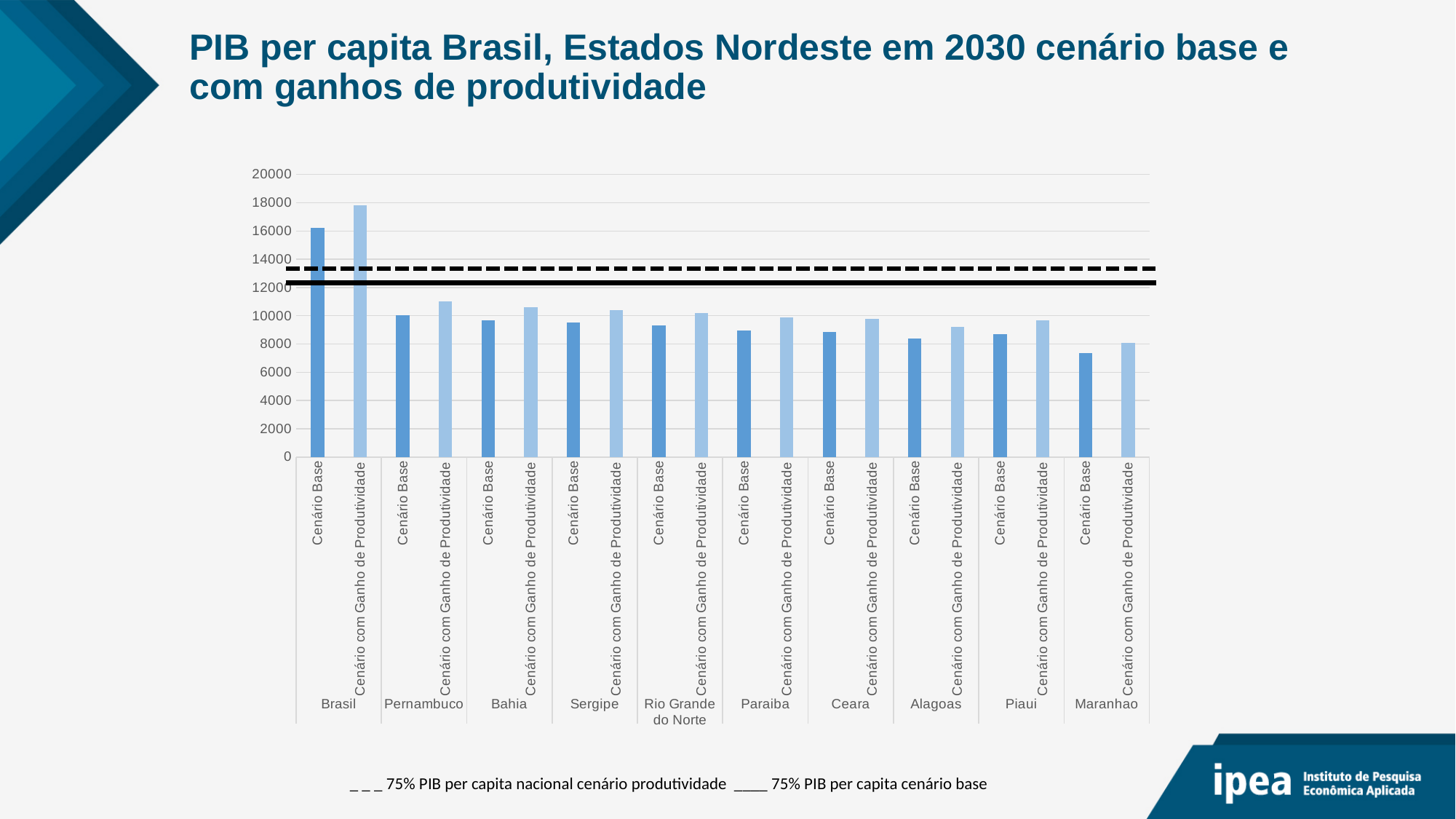
Is the Cenário com Ganho de Produtividade value for Brasil greater or less than 16000? greater Which region has the lowest Cenário Base bar? Maranhao Is the Cenário Base value for Alagoas greater or less than 10000? less For Piaui, which bar is higher: Cenário Base or Cenário com Ganho de Produtividade? Cenário com Ganho de Produtividade Do the Cenário Base values generally rise or fall moving from Brasil to Maranhao along the x axis? fall What kind of chart is shown on the slide? bar chart How many regions (Brasil plus states) are shown along the x axis? 10 Is the Cenário Base value for Brasil greater or less than 14000? greater Which region has the highest Cenário Base bar? Brasil What does the dashed horizontal line on the chart represent? 75% PIB per capita nacional cenário produtividade Which is larger: the Cenário Base value for Brasil or the Cenário com Ganho de Produtividade value for Pernambuco? Cenário Base for Brasil